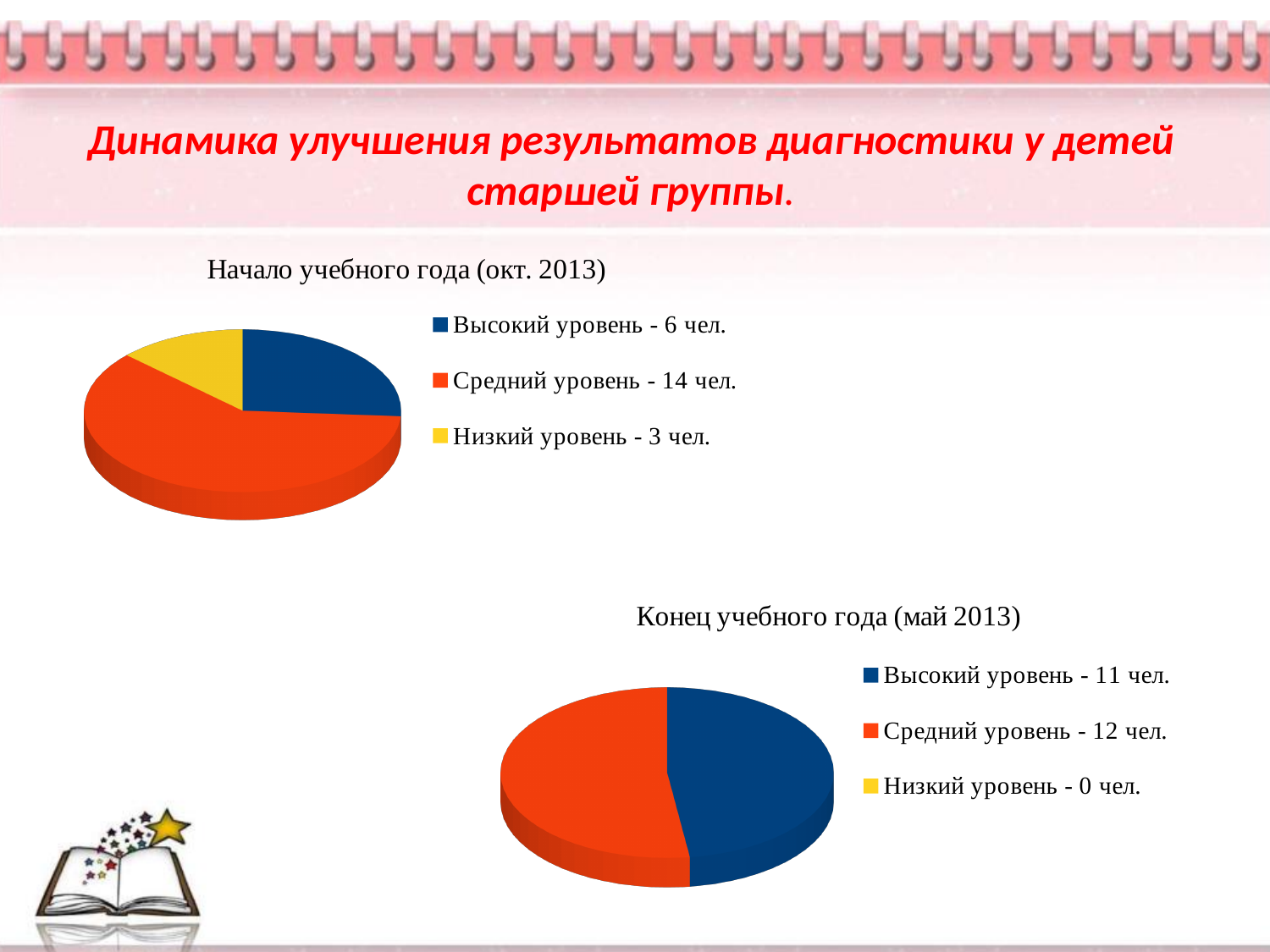
What is the total number of children shown in the chart titled "Конец учебного года (май 2013)"? 23 чел. In the chart titled "Конец учебного года (май 2013)", how many children are at the high level (Высокий уровень)? 11 чел. In the chart titled "Начало учебного года (окт. 2013)", how many children are at the medium level (Средний уровень)? 14 чел. In the chart titled "Начало учебного года (окт. 2013)", which level has the smallest number of children? Низкий уровень In the chart titled "Конец учебного года (май 2013)", how many children are at the low level (Низкий уровень)? 0 чел. In the chart titled "Начало учебного года (окт. 2013)", how many children are at the high level (Высокий уровень)? 6 чел. In the chart titled "Конец учебного года (май 2013)", which level has the smallest number of children? Низкий уровень In the chart titled "Конец учебного года (май 2013)", which is larger: the number of children at the high level or at the medium level? Средний уровень In the chart titled "Начало учебного года (окт. 2013)", what is the difference between the number of children at the medium level and at the high level? 8 чел. How many legend entries does the chart titled "Начало учебного года (окт. 2013)" list? 3 What type of chart is used for "Конец учебного года (май 2013)"? Pie chart In the chart titled "Начало учебного года (окт. 2013)", which level has the largest number of children? Средний уровень